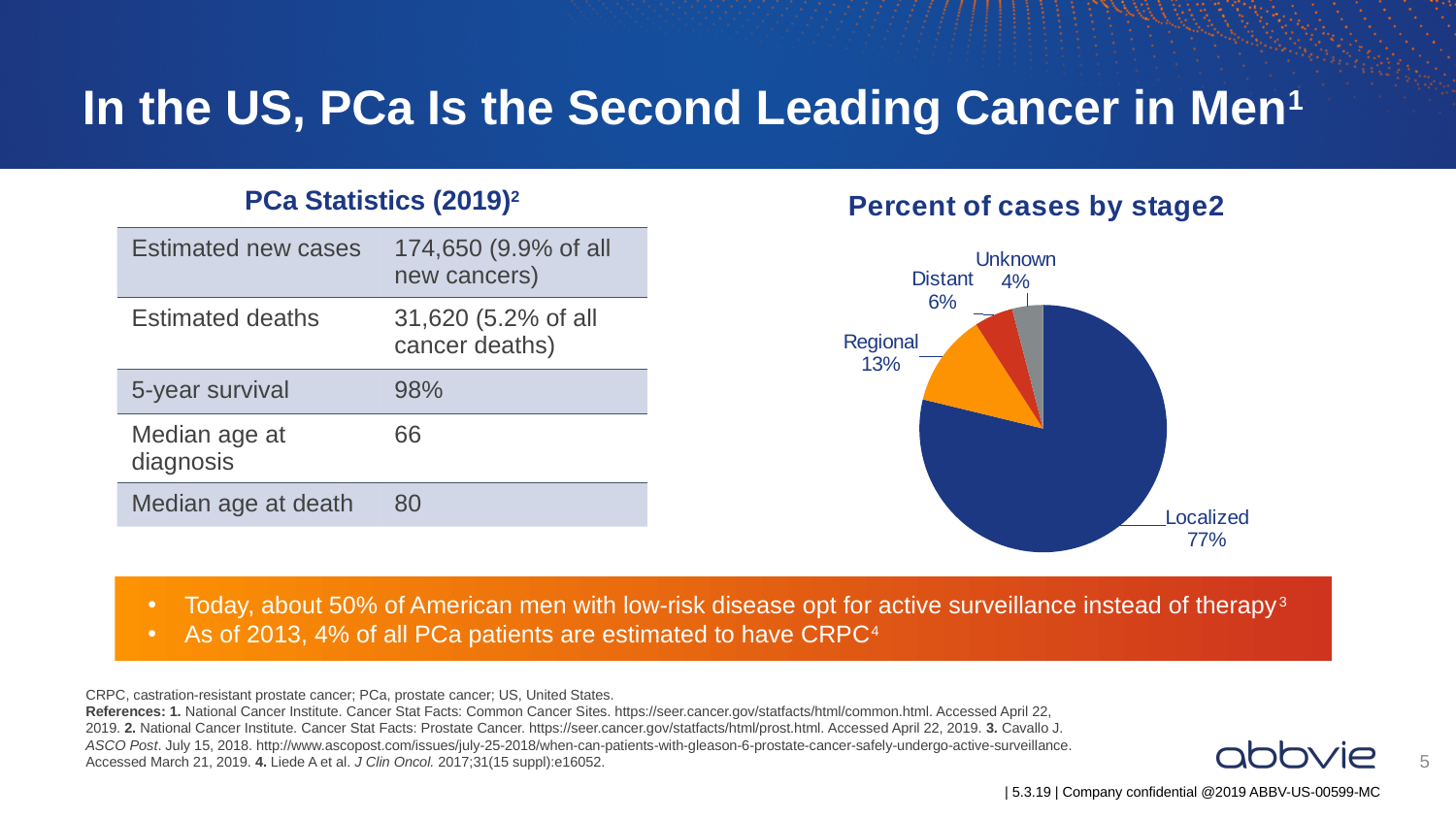
What percentage of cases are Unknown in the pie chart? 4% Which has a larger share of cases in the pie chart, Distant or Unknown? Distant What is the difference in percentage points between Localized and Regional cases in the pie chart? 64 What percentage of cases are Localized in the 'Percent of cases by stage' pie chart? 77% How many stage categories are shown in the pie chart? 4 Which stage has the largest share of cases in the pie chart? Localized What percentage of cases are Regional in the pie chart? 13% What percentage of cases are Distant in the pie chart? 6% What colour is the Localized slice in the pie chart? Blue What is the title of the pie chart on the slide? Percent of cases by stage Which stage has the smallest share of cases in the pie chart? Unknown What type of chart is used to show percent of cases by stage? Pie chart